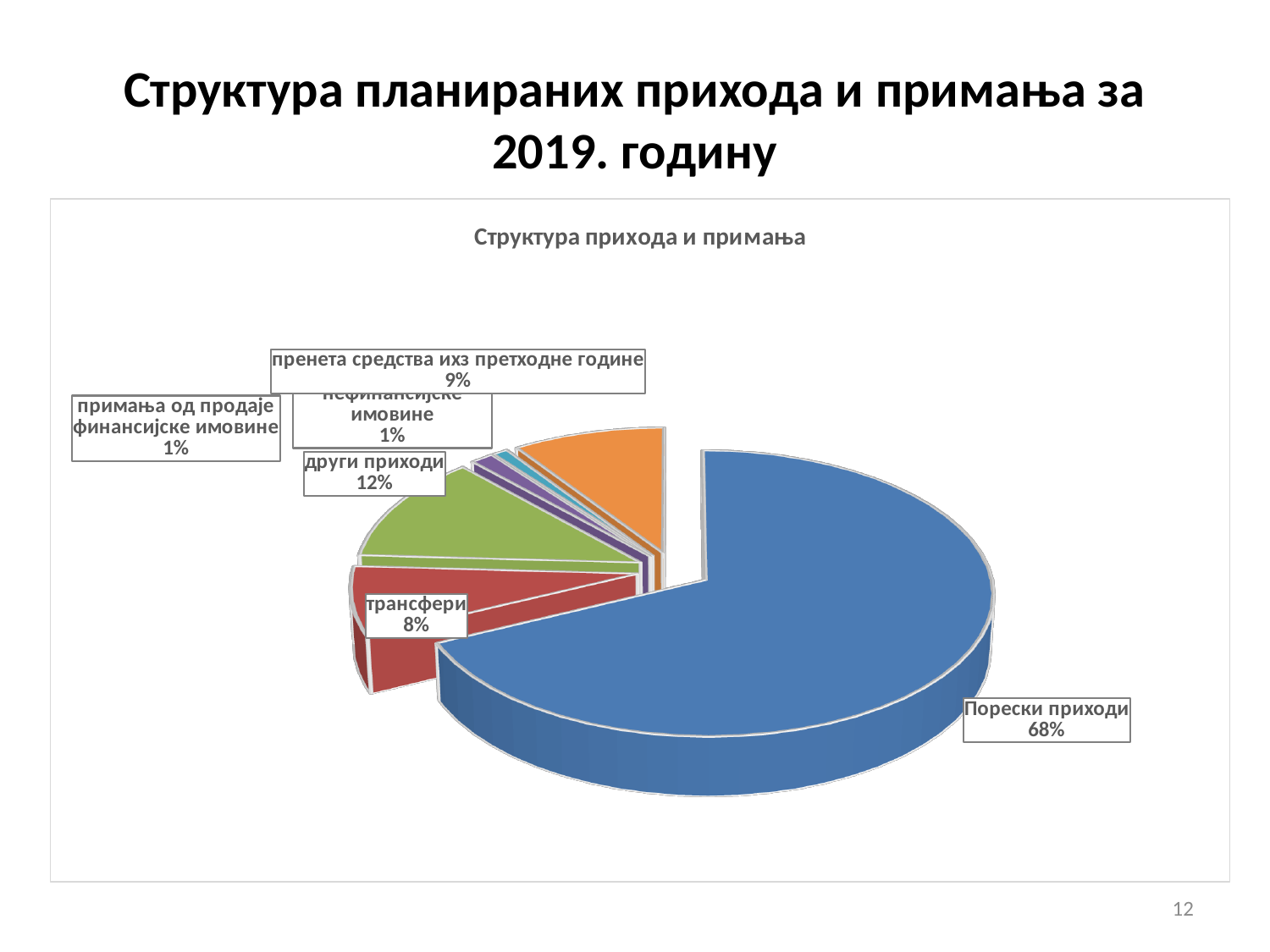
Which is larger, the share for други приходи or the share for трансфери? други приходи What colour is the slice for Порески приходи? blue What share of the pie is други приходи? 12% What share of the pie is примања од продаје финансијске имовине? 1% What is the title of the chart? Структура прихода и примања Which category has the largest share of the pie? Порески приходи What share of the pie is пренета средства ихз претходне године? 9% What is the difference in percentage points between Порески приходи and други приходи? 56 What share of the pie is Порески приходи? 68% What share of the pie is трансфери? 8% How many slices does the pie chart have? 6 What kind of chart is shown on the slide? pie chart